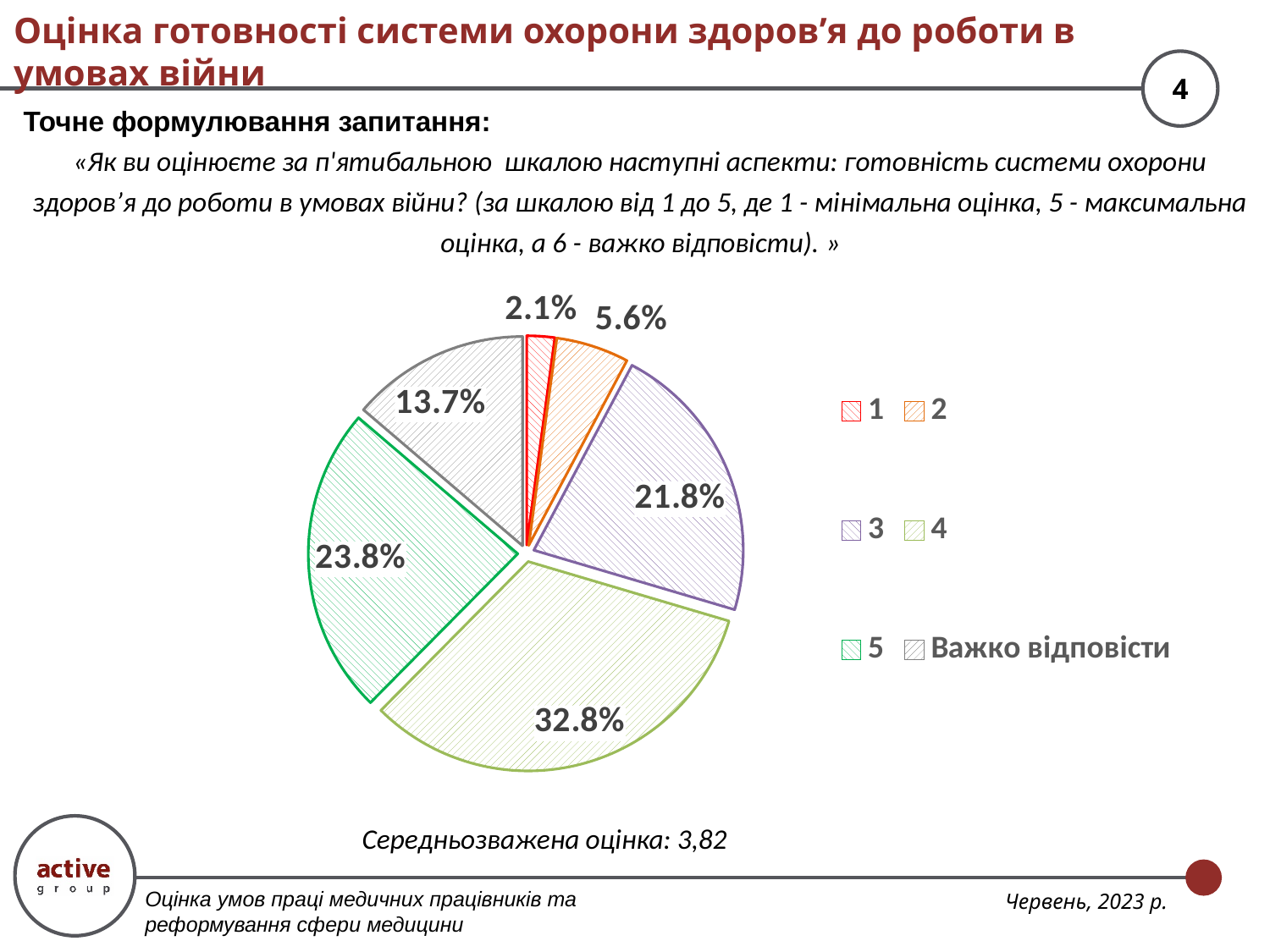
What share of the pie chart corresponds to 'Важко відповісти'? 13.7% How many slices does the pie chart have? 6 What type of chart is shown on the slide? Pie chart Which category has the largest slice in the pie chart? 4 What is the difference in percentage points between the slices for rating 4 and rating 5? 9 percentage points Which category has the smallest slice in the pie chart? 1 What share of the pie chart corresponds to rating 5? 23.8% Which slice is larger: rating 2 or 'Важко відповісти'? Важко відповісти What share of the pie chart corresponds to rating 1? 2.1% What share of the pie chart corresponds to rating 4? 32.8% What share of the pie chart corresponds to rating 3? 21.8% What is the weighted average score stated below the chart? 3,82